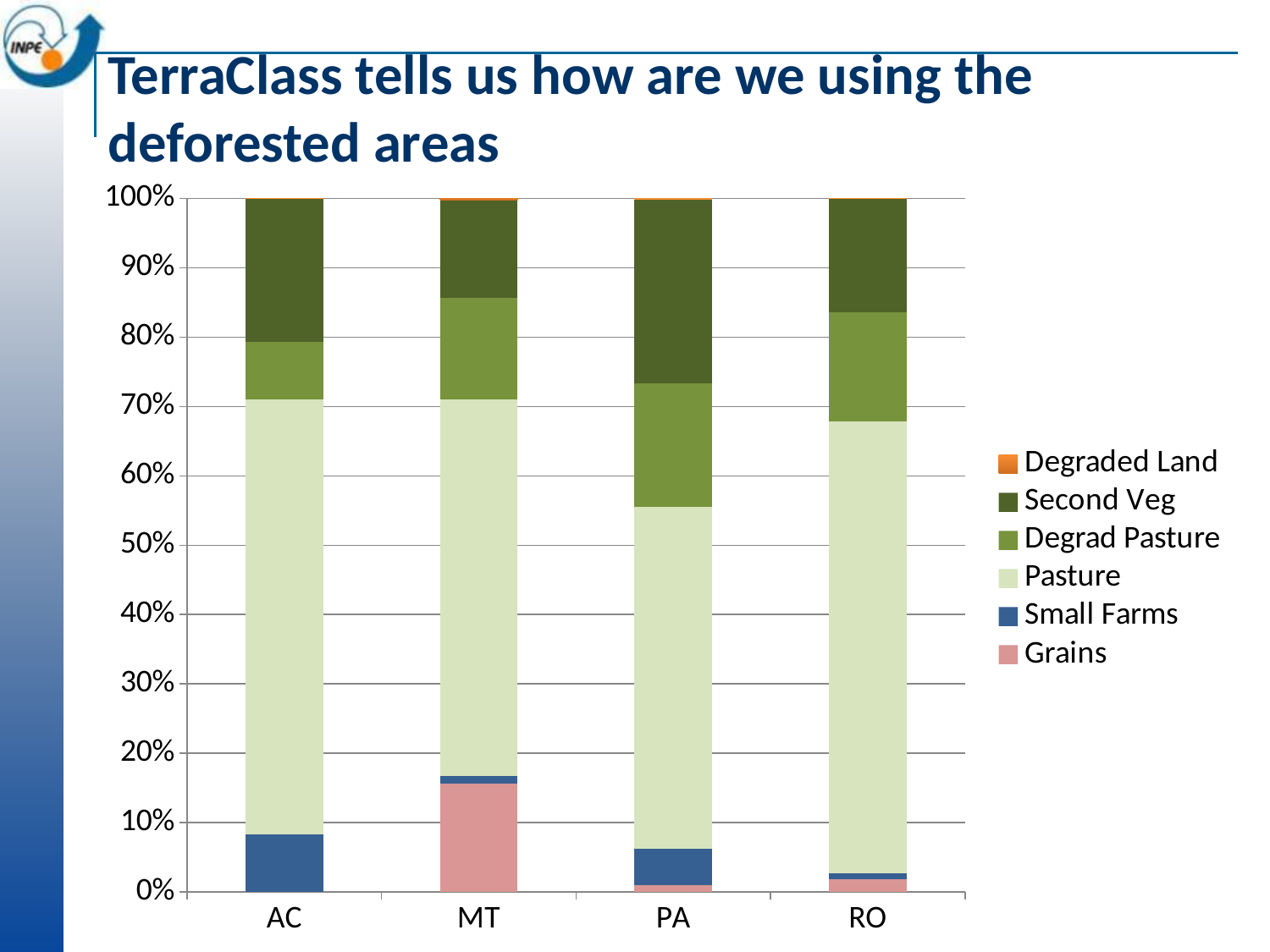
Is the Grains share for MT greater or less than 10%? greater Which state has the largest Second Veg share? PA Which has the larger Degrad Pasture share, PA or AC? PA Which state has the largest Grains share? MT How many states (categories) are shown on the x axis? 4 Which series is listed first in the legend? Degraded Land Is the Second Veg share for PA greater or less than 20%? greater What is the total height of the stacked bar for AC? 100% How many series does the legend list? 6 Is the Second Veg share for MT greater or less than 20%? less What kind of chart is shown on the slide? Stacked bar chart